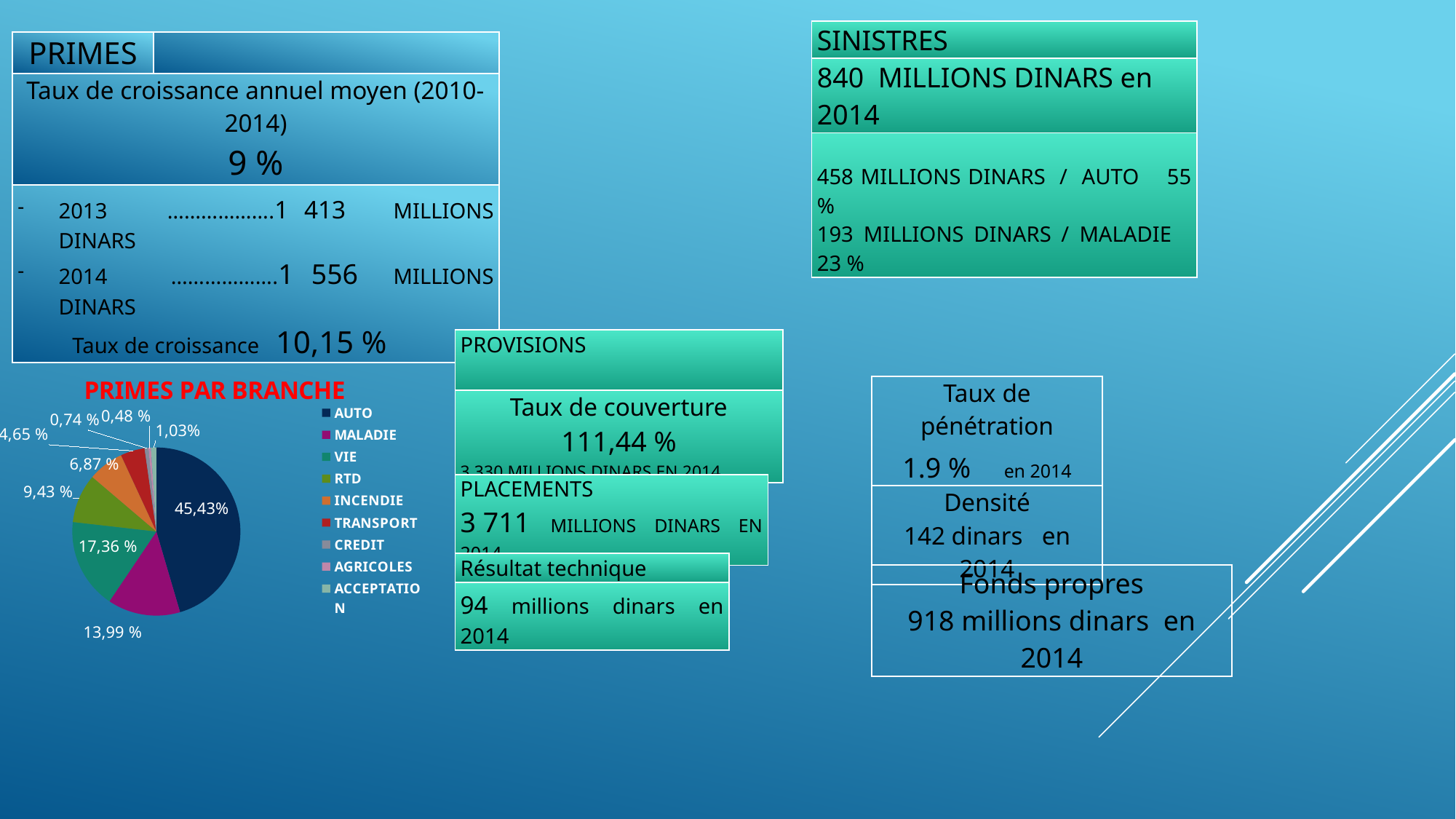
Which branch has the largest slice in the PRIMES PAR BRANCHE pie chart? AUTO Which branch has the smallest slice in the PRIMES PAR BRANCHE pie chart? AGRICOLES In the PRIMES PAR BRANCHE pie chart, what is the difference in percentage points between AUTO and MALADIE? 31,44 What type of chart is shown under the title PRIMES PAR BRANCHE? pie chart In the PRIMES PAR BRANCHE pie chart, what share does VIE have? 17,36 % In the PRIMES PAR BRANCHE pie chart, which is larger, VIE or MALADIE? VIE In the PRIMES PAR BRANCHE pie chart, what share does INCENDIE have? 6,87 % How many entries does the legend of the PRIMES PAR BRANCHE pie chart list? 9 In the PRIMES PAR BRANCHE pie chart, what share does MALADIE have? 13,99 % In the PRIMES PAR BRANCHE pie chart, what share does AUTO have? 45,43% What is the title of the pie chart on the slide? PRIMES PAR BRANCHE How many branches are shown in the PRIMES PAR BRANCHE pie chart? 9